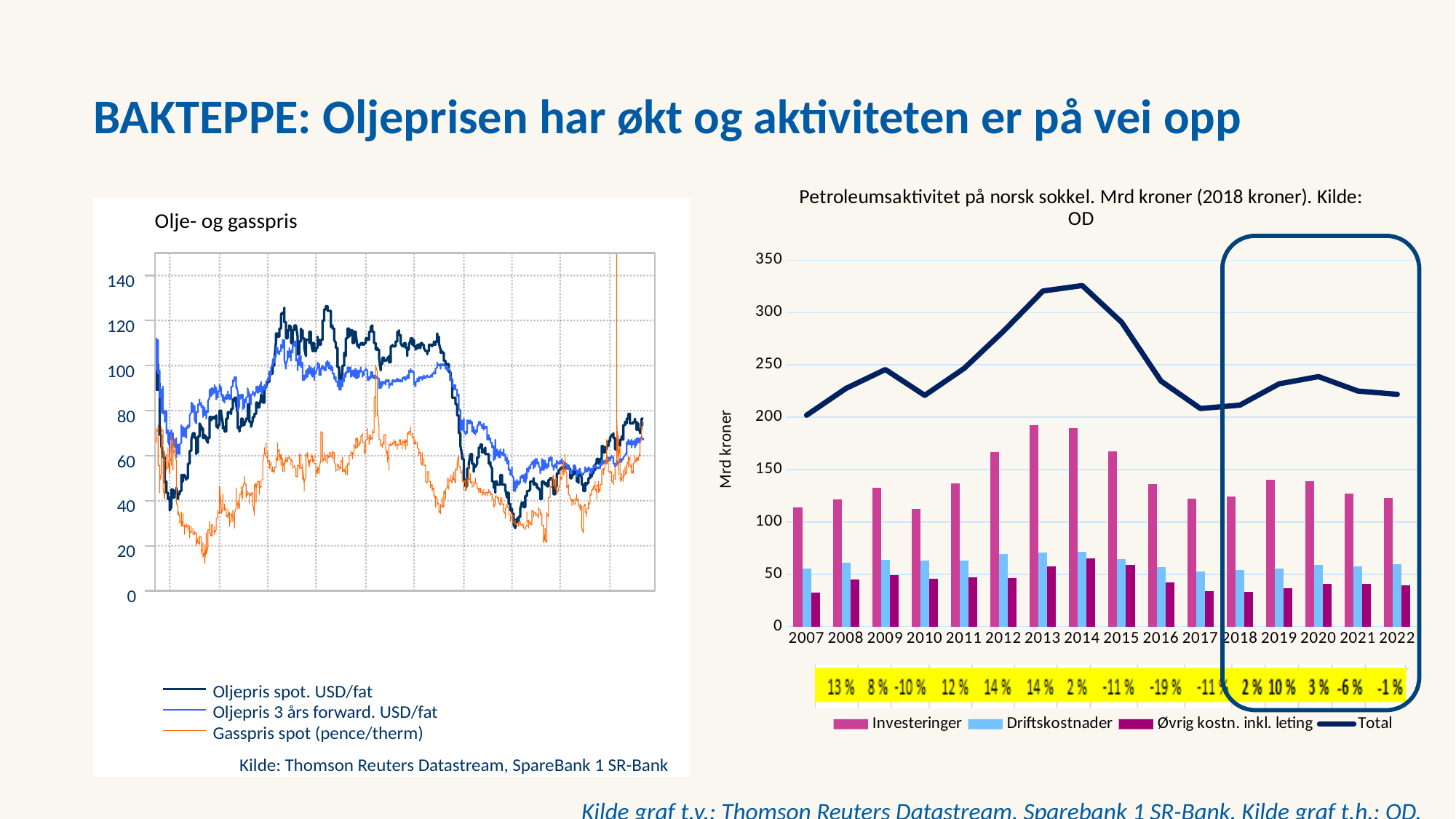
In the left chart 'Olje- og gasspris', what is the unit given in the legend for 'Gasspris spot'? pence/therm How many years are shown on the x axis of the right chart 'Petroleumsaktivitet på norsk sokkel'? 16 In the right chart 'Petroleumsaktivitet på norsk sokkel', is the Driftskostnader value for 2007 greater or less than 100? less In the right chart 'Petroleumsaktivitet på norsk sokkel', which year has the lowest value for Total? 2007 What kind of chart is the left chart titled 'Olje- og gasspris'? line chart How many series does the legend of the left chart 'Olje- og gasspris' list? 3 How many series does the legend of the right chart 'Petroleumsaktivitet på norsk sokkel' list? 4 In the right chart 'Petroleumsaktivitet på norsk sokkel', which is larger: Investeringer in 2013 or Investeringer in 2017? 2013 In the right chart 'Petroleumsaktivitet på norsk sokkel', is the Total value for 2014 greater or less than 300? greater In the right chart 'Petroleumsaktivitet på norsk sokkel', is the Investeringer value for 2013 greater or less than 150? greater What kind of chart is the right chart 'Petroleumsaktivitet på norsk sokkel'? bar chart combined with a line In the right chart 'Petroleumsaktivitet på norsk sokkel', does the Total line rise or fall from 2014 to 2017? fall